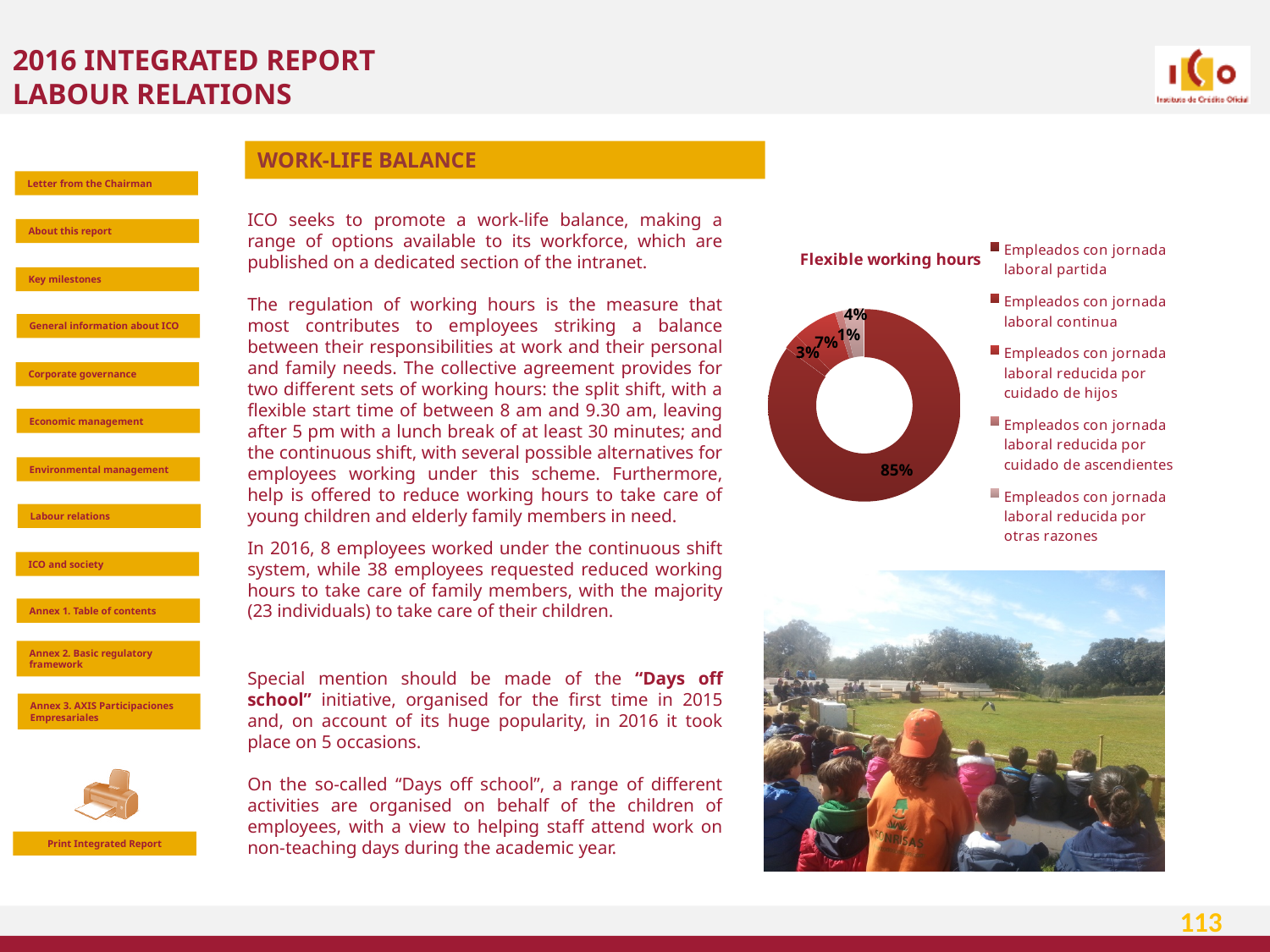
How many entries does the legend of the "Flexible working hours" chart list? 5 How many slices does the "Flexible working hours" doughnut chart have? 5 Which legend entry of the "Flexible working hours" chart is shown in the darkest red colour? Empleados con jornada laboral partida In the "Flexible working hours" chart, what is the difference in percentage points between the 85% slice and the 4% slice? 81 percentage points In the "Flexible working hours" chart, which is larger: the slice for "Empleados con jornada laboral reducida por cuidado de hijos" or the slice for "Empleados con jornada laboral reducida por cuidado de ascendientes"? Empleados con jornada laboral reducida por cuidado de hijos What kind of chart is shown under the title "Flexible working hours"? Doughnut (pie) chart What percentage is shown for "Empleados con jornada laboral reducida por otras razones" in the "Flexible working hours" chart? 4% What is the title of the chart on the slide? Flexible working hours What is the smallest percentage shown on the "Flexible working hours" chart? 1% What is the largest percentage shown on the "Flexible working hours" chart? 85% What share of the "Flexible working hours" chart corresponds to "Empleados con jornada laboral partida"? 85% What percentage is shown for "Empleados con jornada laboral reducida por cuidado de hijos" in the "Flexible working hours" chart? 7%